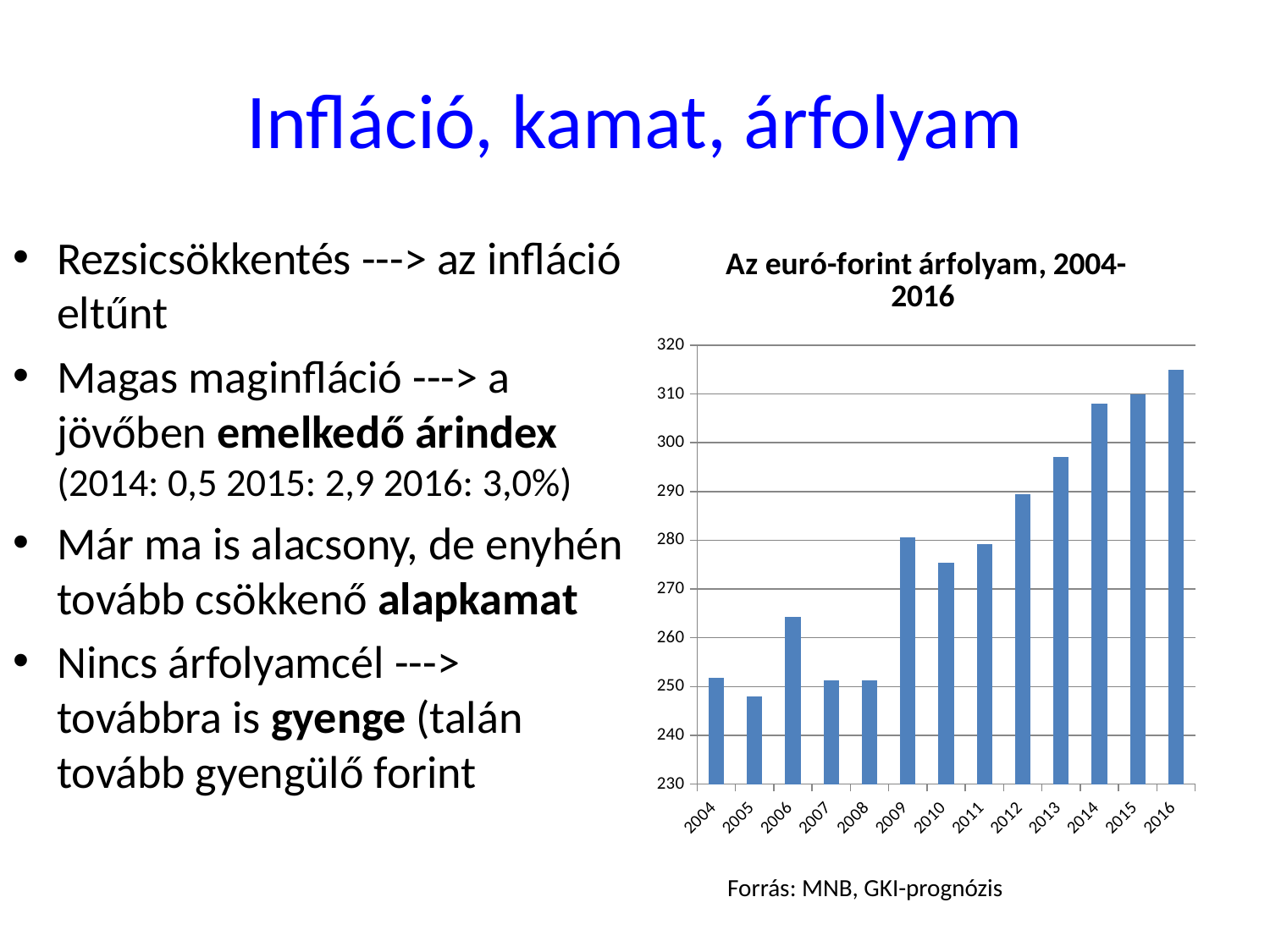
Which year has the higher value, 2006 or 2007? 2006 Which year has the lowest euro-forint exchange rate in the chart? 2005 How many years (bars) are plotted in the chart? 13 What source is cited below the chart? Forrás: MNB, GKI-prognózis Which year has the higher value, 2009 or 2010? 2009 Do the values generally rise or fall from 2004 to 2016? rise Is the value for 2014 greater or less than 300? greater Is the value for 2010 greater or less than 280? less Is the value for 2013 greater or less than 290? greater What type of chart is shown on the slide? bar chart Which year has the highest euro-forint exchange rate in the chart? 2016 What is the title of the chart? Az euró-forint árfolyam, 2004-2016